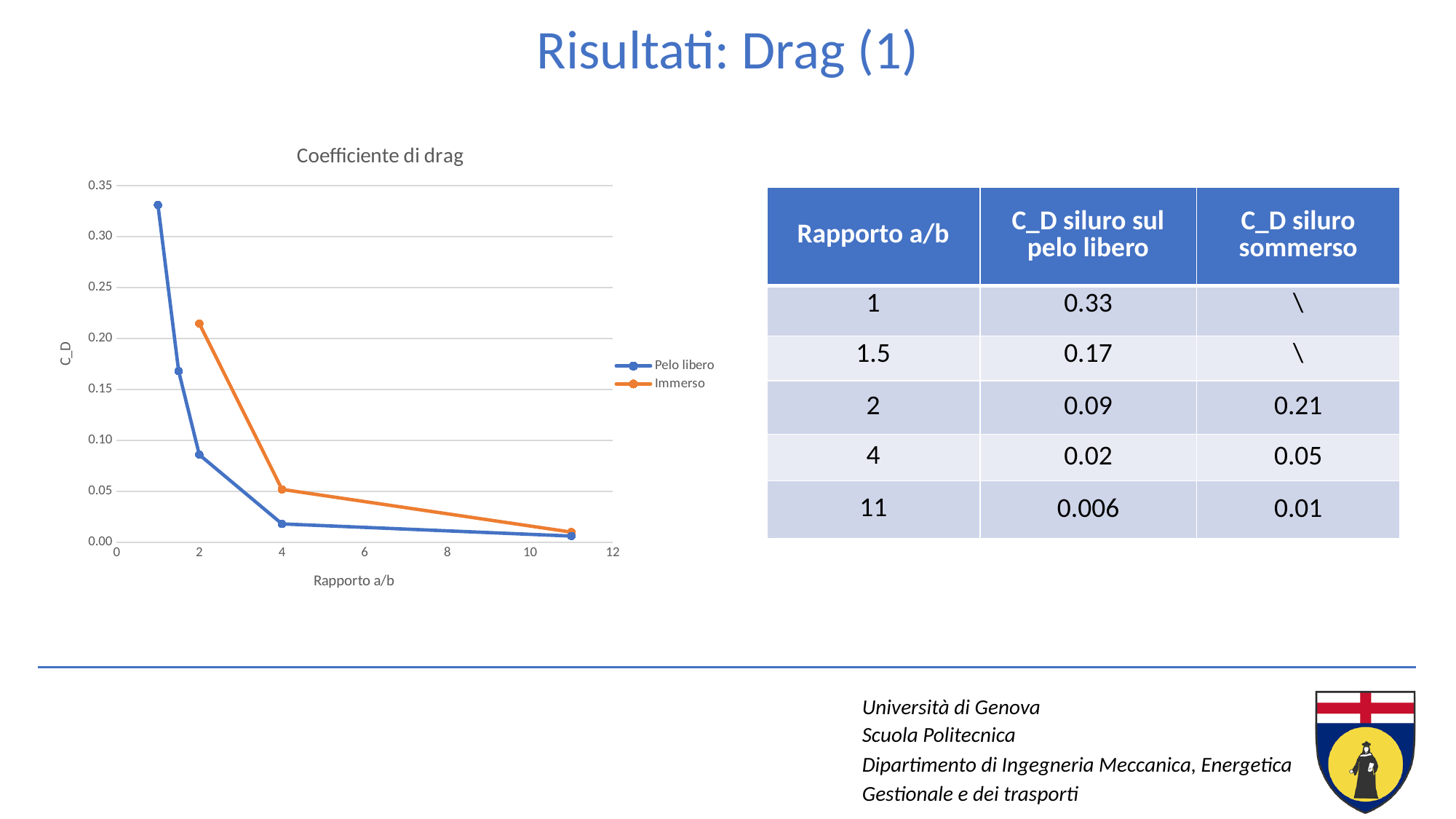
What is the label of the x axis of the chart? Rapporto a/b How many series does the legend of the 'Coefficiente di drag' chart list? 2 At which Rapporto a/b does the 'Pelo libero' series reach its highest C_D value? 1 What kind of chart is shown on the slide? line chart What are the two series named in the legend of the chart? Pelo libero and Immerso Do the C_D values of the 'Pelo libero' series rise or fall as Rapporto a/b increases? fall Is the C_D value of the 'Immerso' series at Rapporto a/b = 2 greater or less than 0.20? greater How many data points does the 'Pelo libero' series have in the chart? 5 Is the C_D value of the 'Immerso' series at Rapporto a/b = 4 greater or less than 0.10? less Is the C_D value of the 'Pelo libero' series at Rapporto a/b = 1 greater or less than 0.30? greater How many data points does the 'Immerso' series have in the chart? 3 At Rapporto a/b = 2, which series has the larger C_D value, 'Pelo libero' or 'Immerso'? Immerso